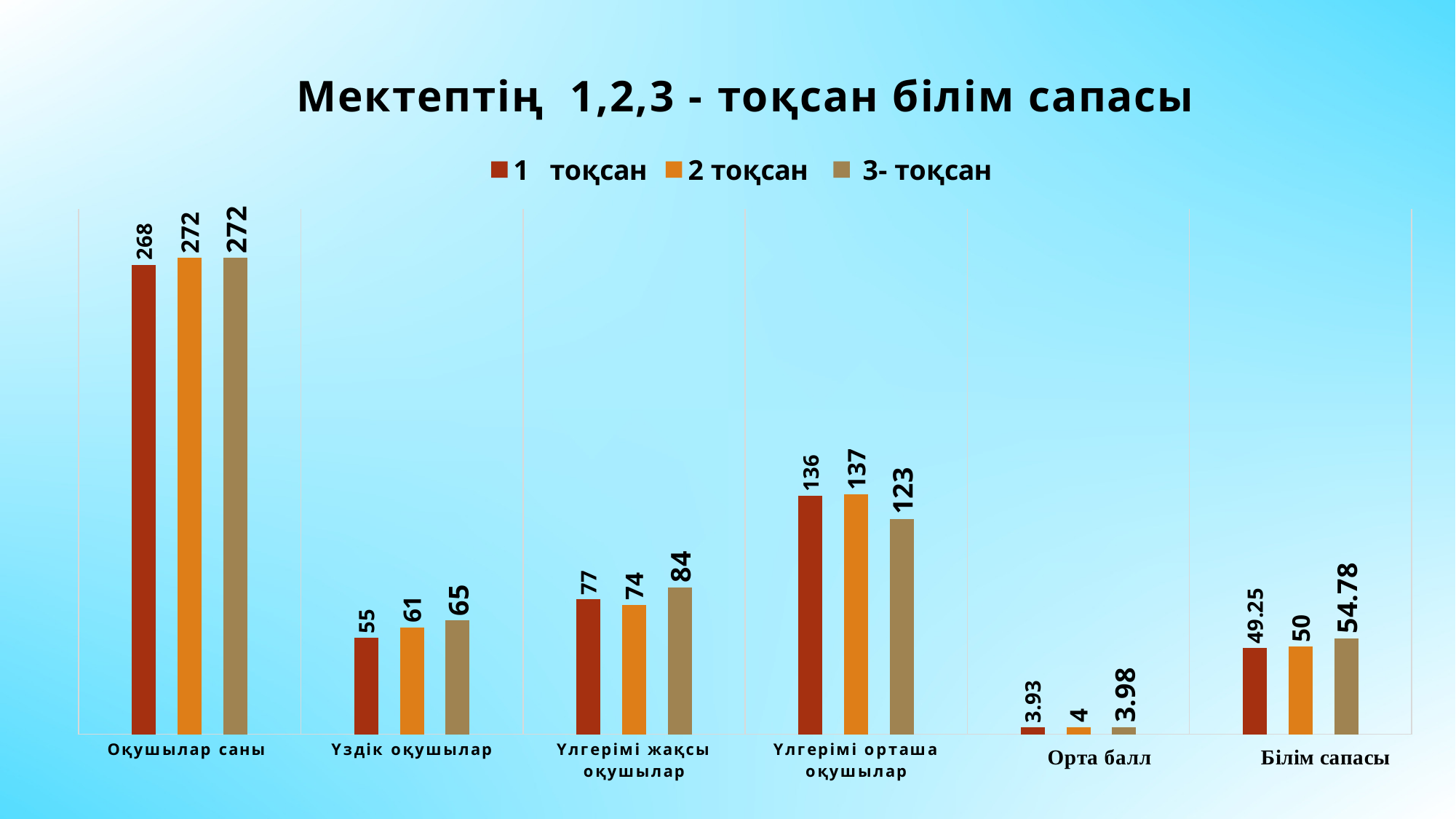
What kind of chart is shown on the slide? Bar chart What is the value for Үздік оқушылар in the 3- тоқсан series? 65 What is the title of the chart? Мектептің 1,2,3 - тоқсан білім сапасы How many series does the legend list? 3 How many categories are shown on the x axis? 6 What is the value for Оқушылар саны in the 1 тоқсан series? 268 What is the value for Білім сапасы in the 1 тоқсан series? 49.25 Which is larger for Үлгерімі жақсы оқушылар: the 1 тоқсан value or the 3- тоқсан value? 3- тоқсан What is the difference between the 2 тоқсан and 3- тоқсан values for Үлгерімі орташа оқушылар? 14 Which category has the lowest value in the 3- тоқсан series? Орта балл Which category has the highest value in the 2 тоқсан series? Оқушылар саны What is the value for Орта балл in the 2 тоқсан series? 4